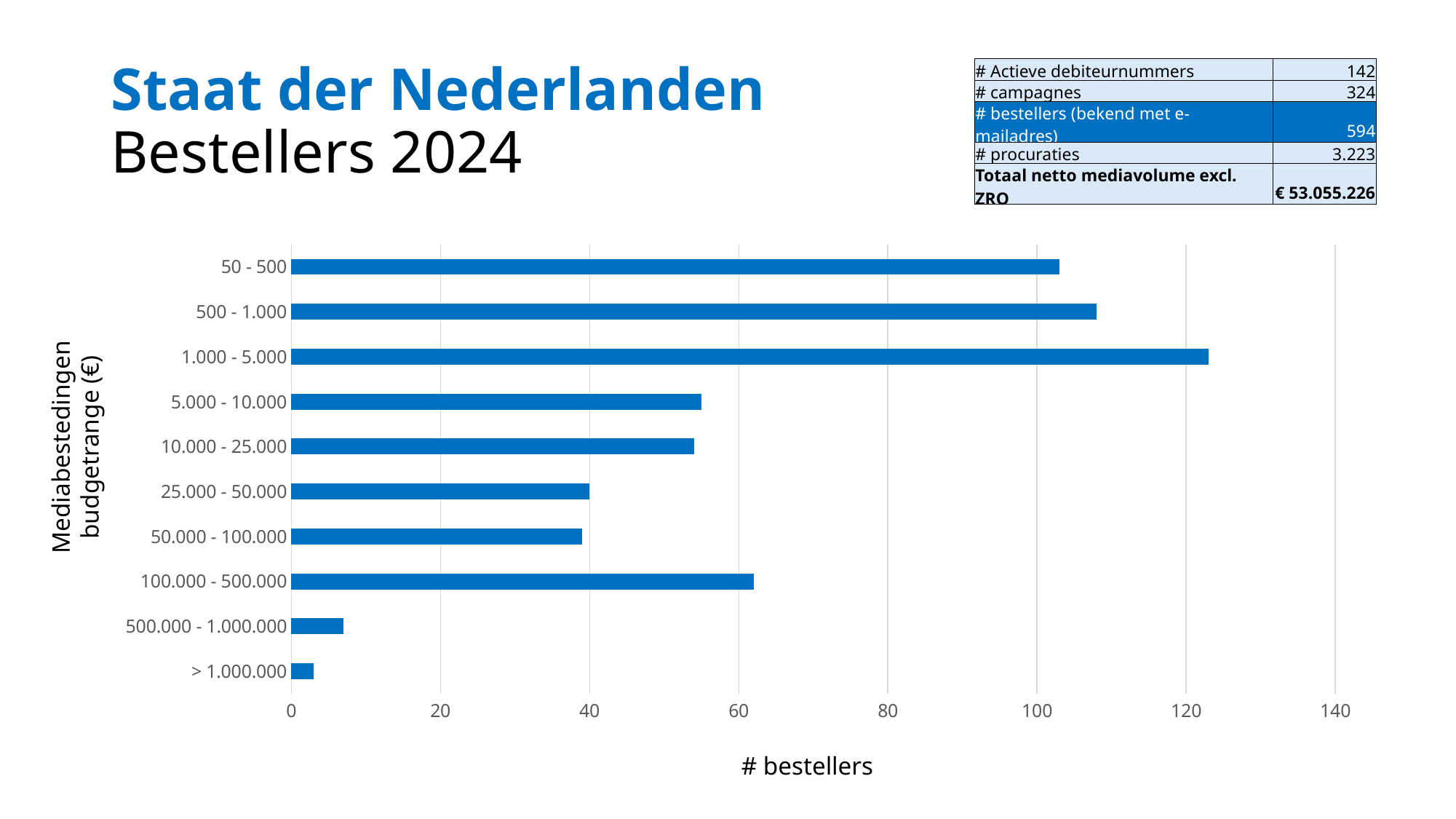
Which has more bestellers: the 500 - 1.000 budget range or the 5.000 - 10.000 budget range? 500 - 1.000 Which has more bestellers: the 100.000 - 500.000 budget range or the 50.000 - 100.000 budget range? 100.000 - 500.000 Is the number of bestellers for the 1.000 - 5.000 budget range greater or less than 120? greater Is the number of bestellers for the 100.000 - 500.000 budget range greater or less than 60? greater How many budget range categories are plotted in the chart? 10 Which budget range has the highest number of bestellers? 1.000 - 5.000 Is the number of bestellers for the 25.000 - 50.000 budget range greater or less than 60? less Which budget range has the lowest number of bestellers? > 1.000.000 What is the label of the horizontal axis of the chart? # bestellers What kind of chart is shown on the slide? bar chart